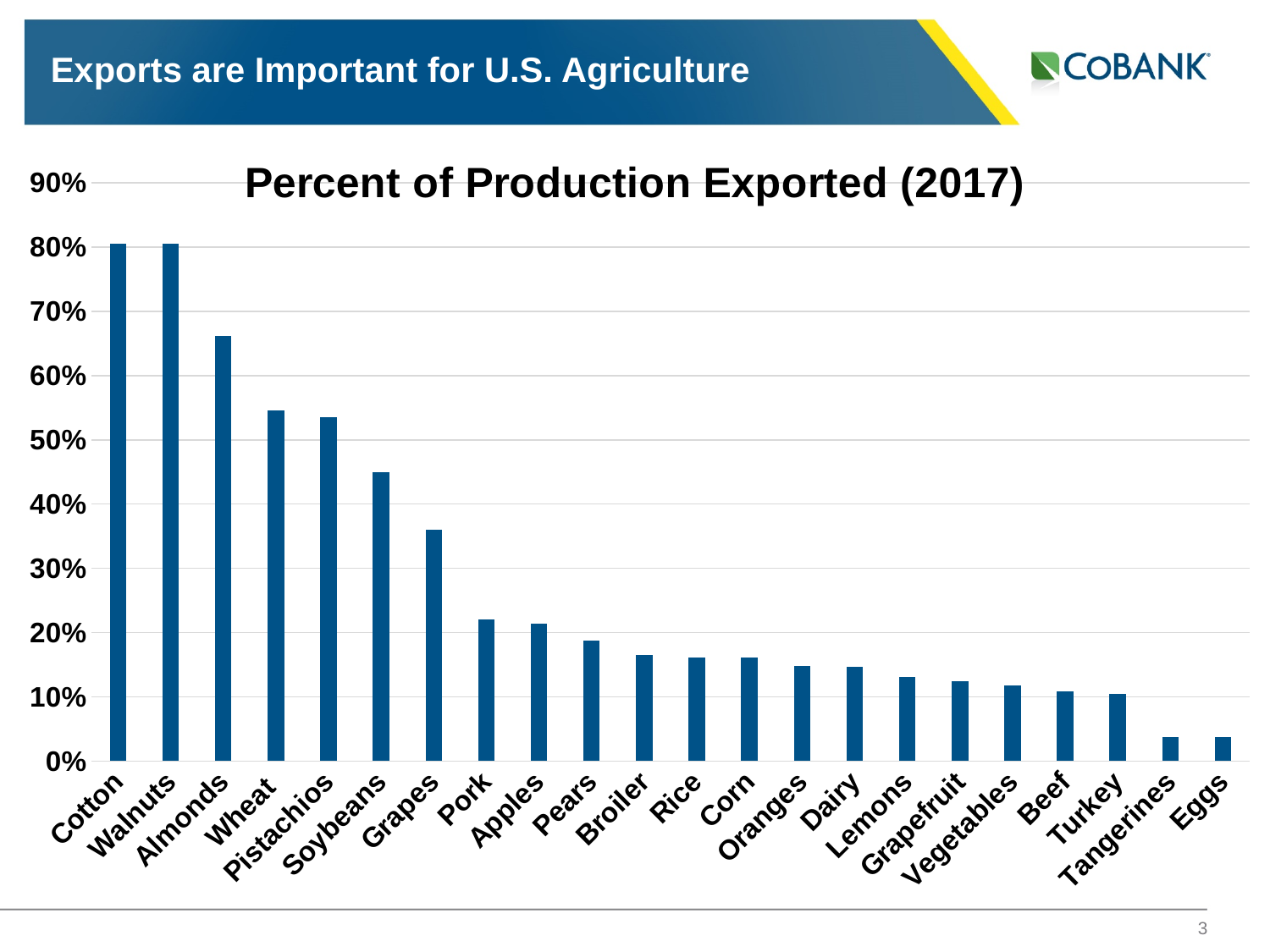
Is the value for Almonds greater or less than 60%? greater How many categories are plotted on the chart? 22 What is the title of the chart? Percent of Production Exported (2017) Which has a higher value, Beef or Grapes? Grapes Is the value for Grapes greater or less than 30%? greater Is the value for Cotton greater or less than 70%? greater What type of chart is shown on the slide? bar chart Do the values generally rise or fall moving from left to right along the x axis? fall Which has a higher value, Almonds or Wheat? Almonds